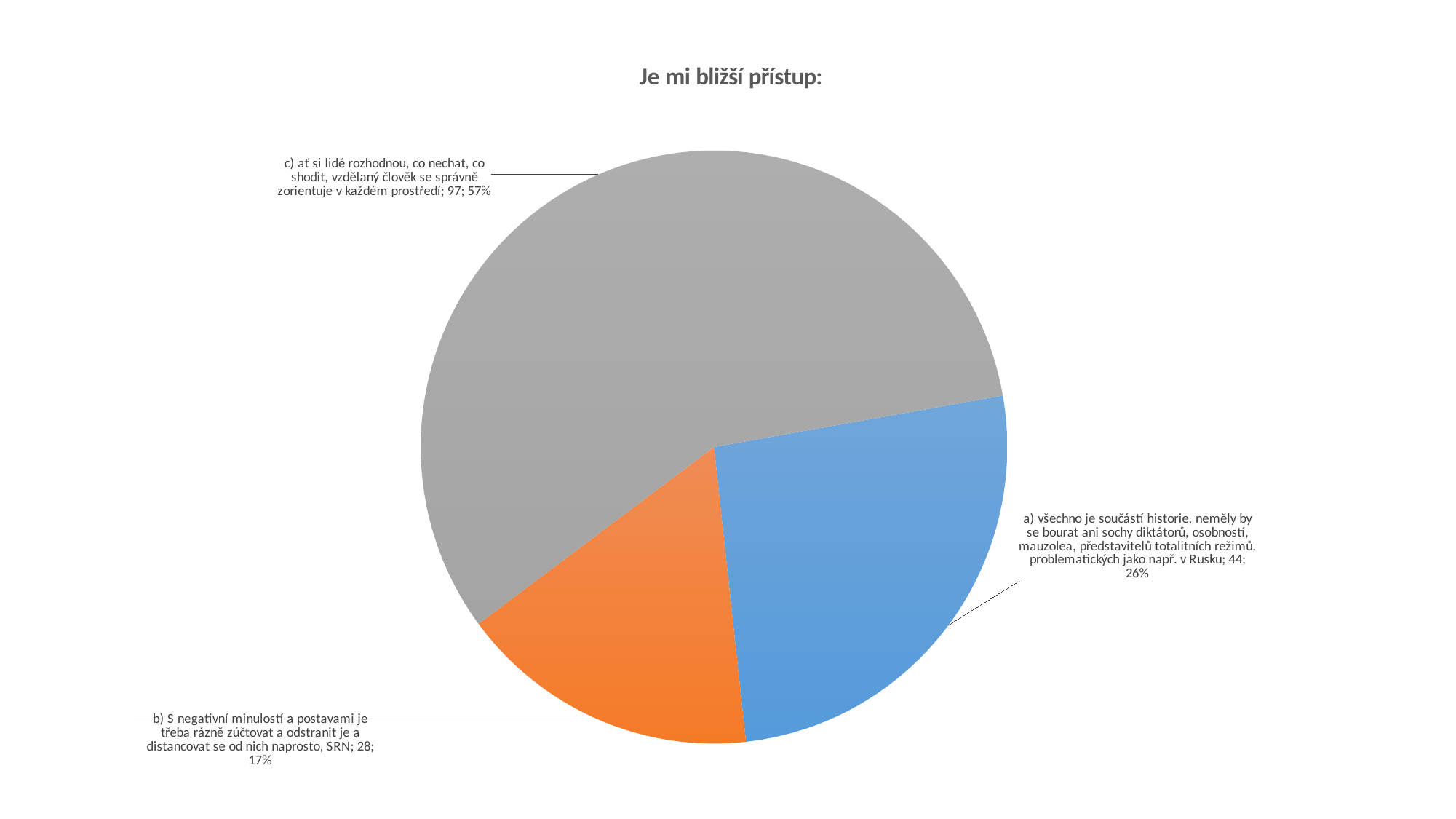
What colour is the slice for option b)? orange Which option has the smallest slice? b) S negativní minulostí a postavami je třeba rázně zúčtovat a odstranit je a distancovat se od nich naprosto, SRN Which option has the largest slice? c) ať si lidé rozhodnou, co nechat, co shodit, vzdělaný člověk se správně zorientuje v každém prostředí How many slices does the pie chart have? 3 What is the count for option c) (ať si lidé rozhodnou, co nechat, co shodit)? 97 What percentage share does option c) have? 57% What is the count for option b) (S negativní minulostí a postavami je třeba rázně zúčtovat)? 28 Which has a larger count, option a) or option b)? a) všechno je součástí historie What is the title of the chart? Je mi bližší přístup: What is the difference in count between option c) and option a)? 53 What percentage share does option a) (všechno je součástí historie) have? 26% What kind of chart is shown on the slide? pie chart